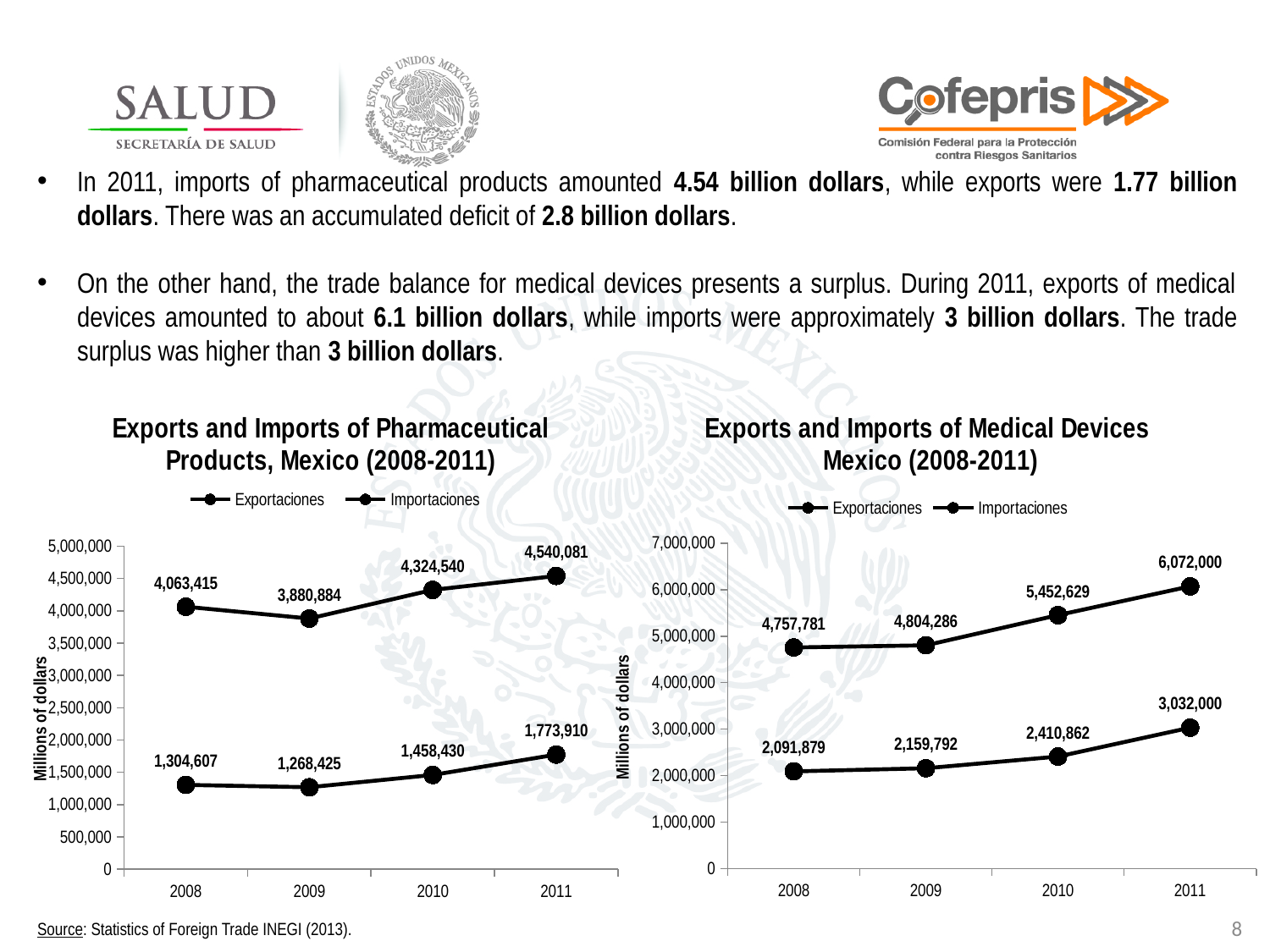
What kind of chart is the Exports and Imports of Pharmaceutical Products chart? Line chart In the Exports and Imports of Pharmaceutical Products chart, what is the value of Exportaciones in 2008? 1,304,607 In the Exports and Imports of Medical Devices chart, what is the value of Importaciones in 2011? 3,032,000 In the Exports and Imports of Pharmaceutical Products chart, what is the value of Importaciones in 2011? 4,540,081 In the Exports and Imports of Medical Devices chart, what is the difference between Exportaciones and Importaciones in 2011? 3,040,000 In the Exports and Imports of Pharmaceutical Products chart, in which year is Exportaciones lowest? 2009 In the Exports and Imports of Medical Devices chart, in which year is Exportaciones highest? 2011 In the Exports and Imports of Pharmaceutical Products chart, which is larger: Importaciones in 2008 or Importaciones in 2009? Importaciones in 2008 In the Exports and Imports of Medical Devices chart, what is the value of Exportaciones in 2010? 5,452,629 How many series does the legend of the Exports and Imports of Medical Devices chart list? 2 In the Exports and Imports of Medical Devices chart, does Importaciones rise or fall from 2008 to 2011? Rise In the Exports and Imports of Pharmaceutical Products chart, what is the difference between Importaciones and Exportaciones in 2011? 2,766,171